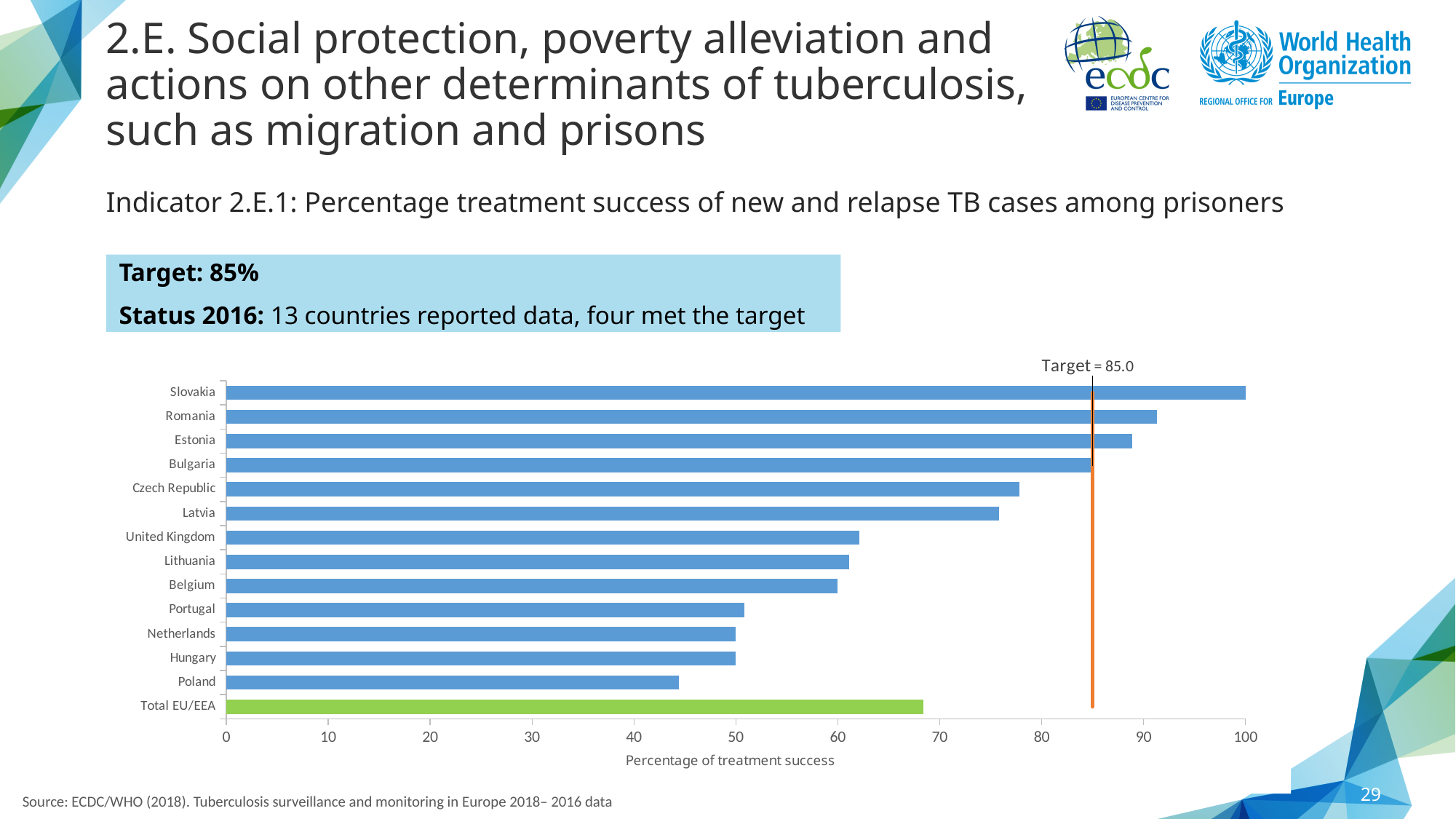
Which has a higher percentage of treatment success, Belgium or Portugal? Belgium Is the value for Czech Republic greater or less than 70? greater Is the value for Lithuania greater or less than 70? less Is the value for Poland greater or less than 50? less What target value is marked by the vertical line in the chart? 85.0 What kind of chart is shown on the slide? bar chart Which country has the lowest percentage of treatment success in the chart? Poland Which has a higher percentage of treatment success, Latvia or United Kingdom? Latvia Which country has the highest percentage of treatment success in the chart? Slovakia How many bars are plotted in the chart? 14